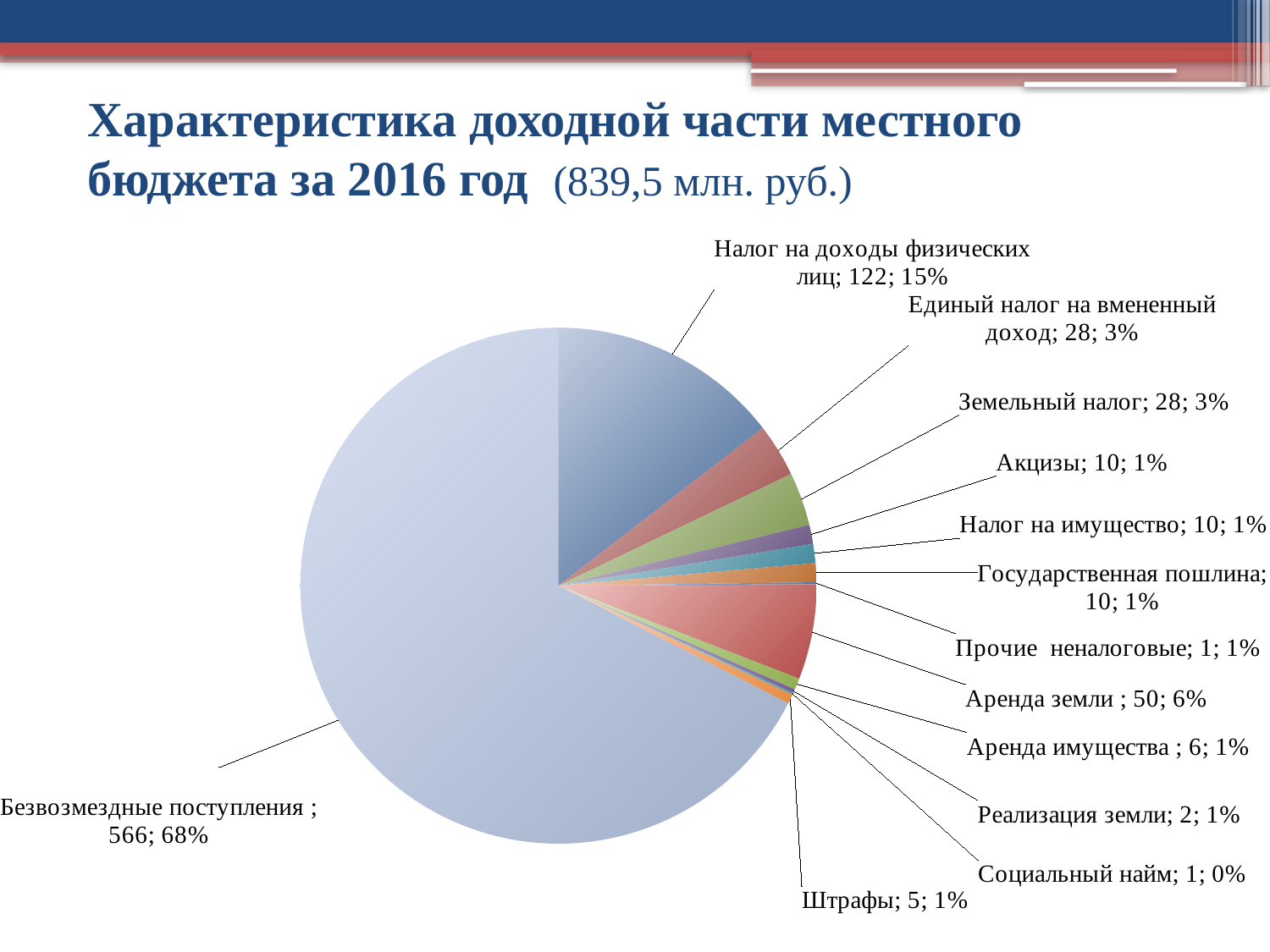
What kind of chart is shown on the slide? pie chart What total amount in million rubles is given in the slide title? 839,5 млн. руб. Which category has the largest slice of the pie? Безвозмездные поступления What is the value for Безвозмездные поступления? 566 Which is larger, the value for Аренда земли or the value for Земельный налог? Аренда земли What is the value for Аренда земли? 50 What is the difference between the values for Аренда земли and Аренда имущества? 44 How many categories (slices) does the pie chart show? 13 What share of the pie does Аренда земли represent? 6% What share of the pie does Налог на доходы физических лиц represent? 15% What is the difference between the values for Безвозмездные поступления and Налог на доходы физических лиц? 444 What is the value for Налог на доходы физических лиц? 122